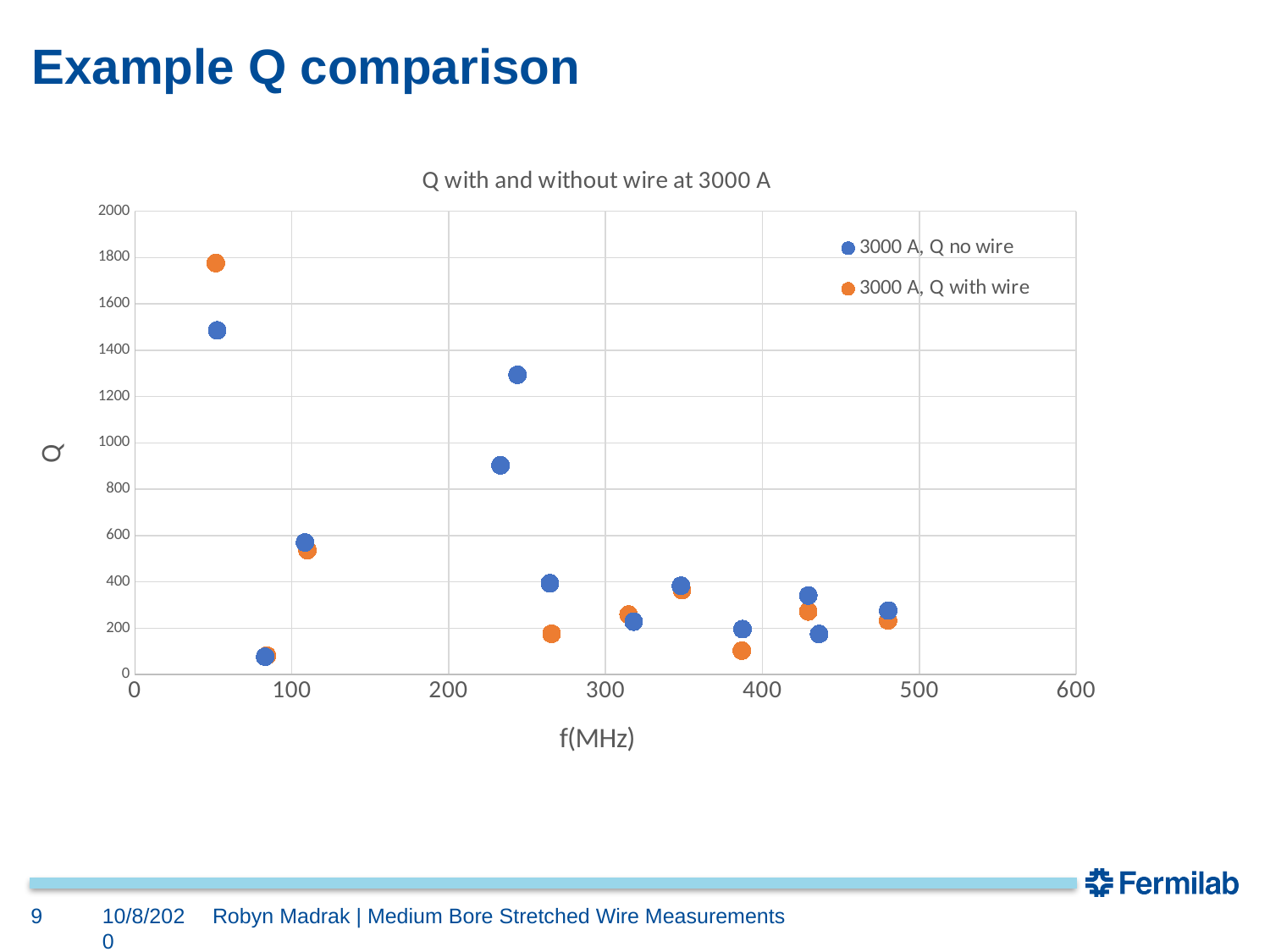
Do the Q values generally rise or fall as frequency increases from 0 to 600 MHz? fall What is the label on the x axis of the chart? f(MHz) Is the Q value for the '3000 A, Q no wire' point near 50 MHz greater or less than 1600? less Near 50 MHz, which series has the higher Q value: '3000 A, Q no wire' or '3000 A, Q with wire'? 3000 A, Q with wire How many series does the legend list? 2 Which series contains the highest Q value plotted on the chart? 3000 A, Q with wire Is the Q value for the '3000 A, Q with wire' point near 390 MHz greater or less than 200? less Is the Q value for the '3000 A, Q no wire' point near 240 MHz greater or less than 1200? greater What kind of chart is shown on the slide? Scatter chart What is the title of the chart? Q with and without wire at 3000 A Near 390 MHz, which series has the higher Q value: '3000 A, Q no wire' or '3000 A, Q with wire'? 3000 A, Q no wire